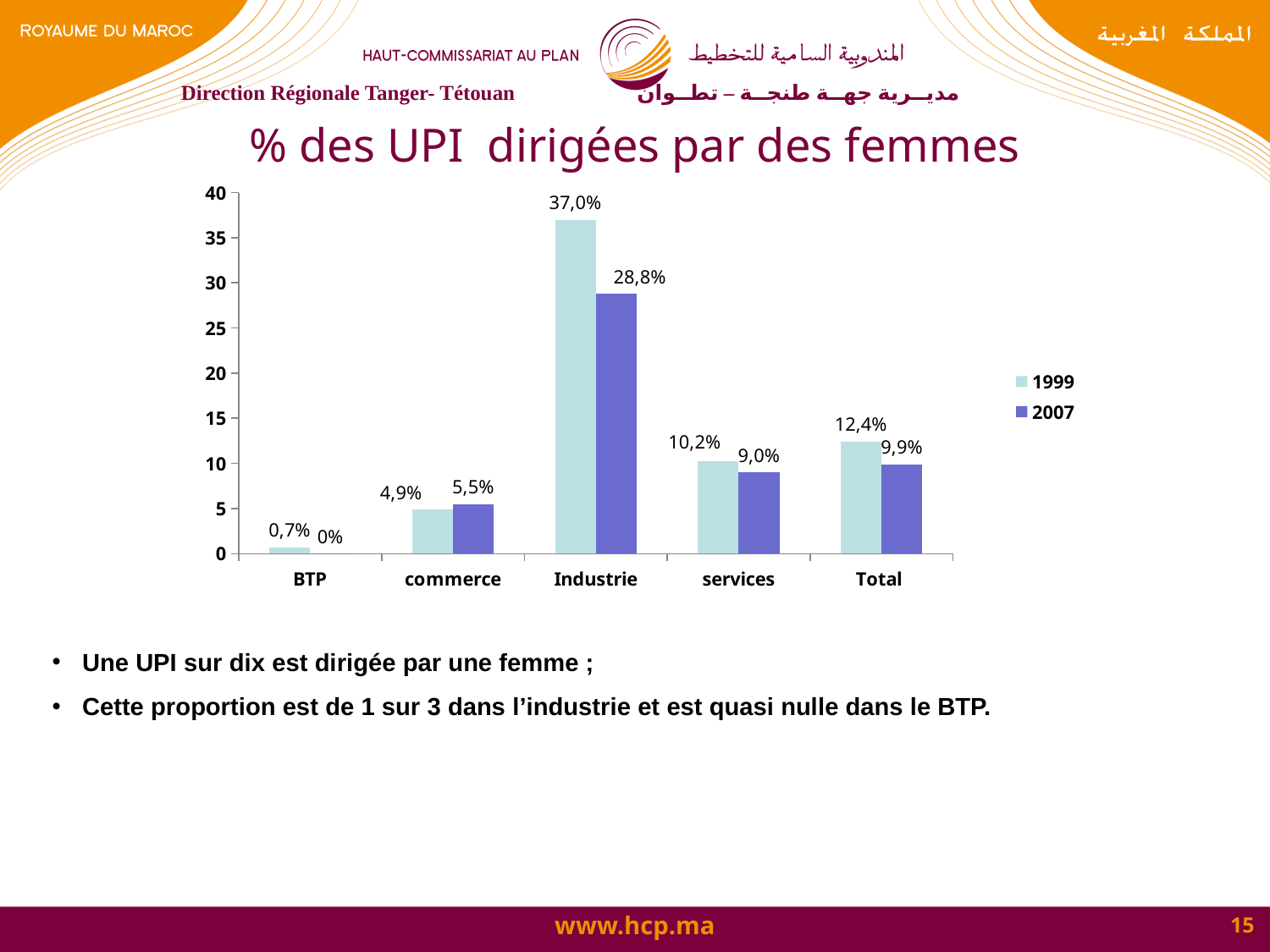
What is the value for Total in 1999? 12,4% What is the value for commerce in 2007? 5,5% How many series does the legend list? 2 Which category has the highest value in 2007? Industrie What kind of chart is shown on the slide? bar chart What is the title of the chart? % des UPI dirigées par des femmes What is the value for BTP in 2007? 0% What is the value for Industrie in 1999? 37,0% What is the difference between the 1999 and 2007 values for Industrie? 8,2% Which is larger for services: the 1999 value or the 2007 value? 1999 Which category has the lowest value in 1999? BTP How many categories are shown on the x axis? 5